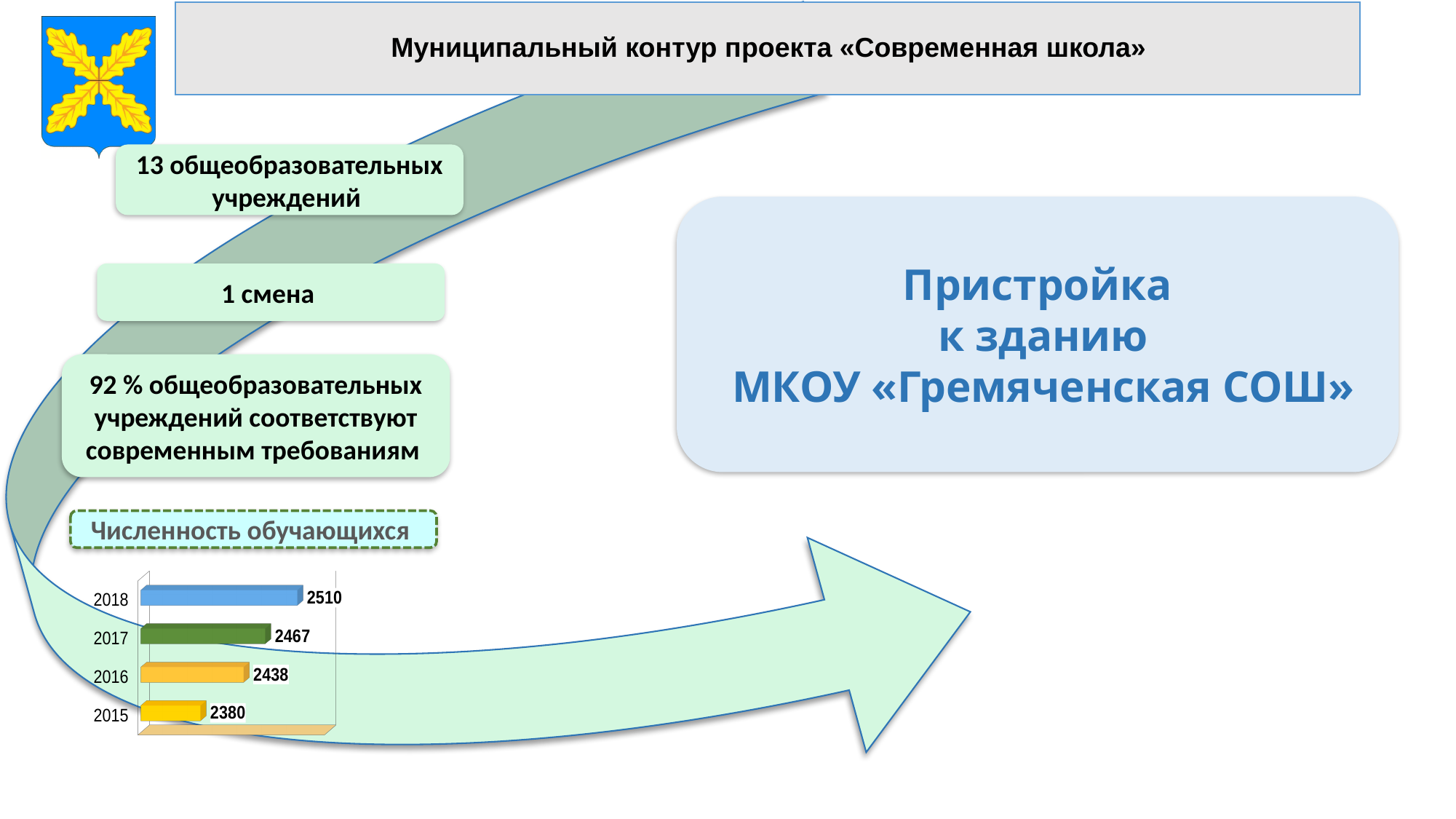
What is the difference between the values for 2018 and 2015? 130 What is the number of students shown for 2018? 2510 What is the difference between the values for 2017 and 2016? 29 How many years are shown in the chart? 4 Which year has the lowest number of students? 2015 Which year has the highest number of students? 2018 Does the number of students rise or fall from 2015 to 2018? rise Which is larger, the value for 2016 or the value for 2017? 2017 What value is shown for 2017? 2467 What value is shown for 2016? 2438 What is the number of students shown for 2015? 2380 What kind of chart is used to show the number of students? bar chart